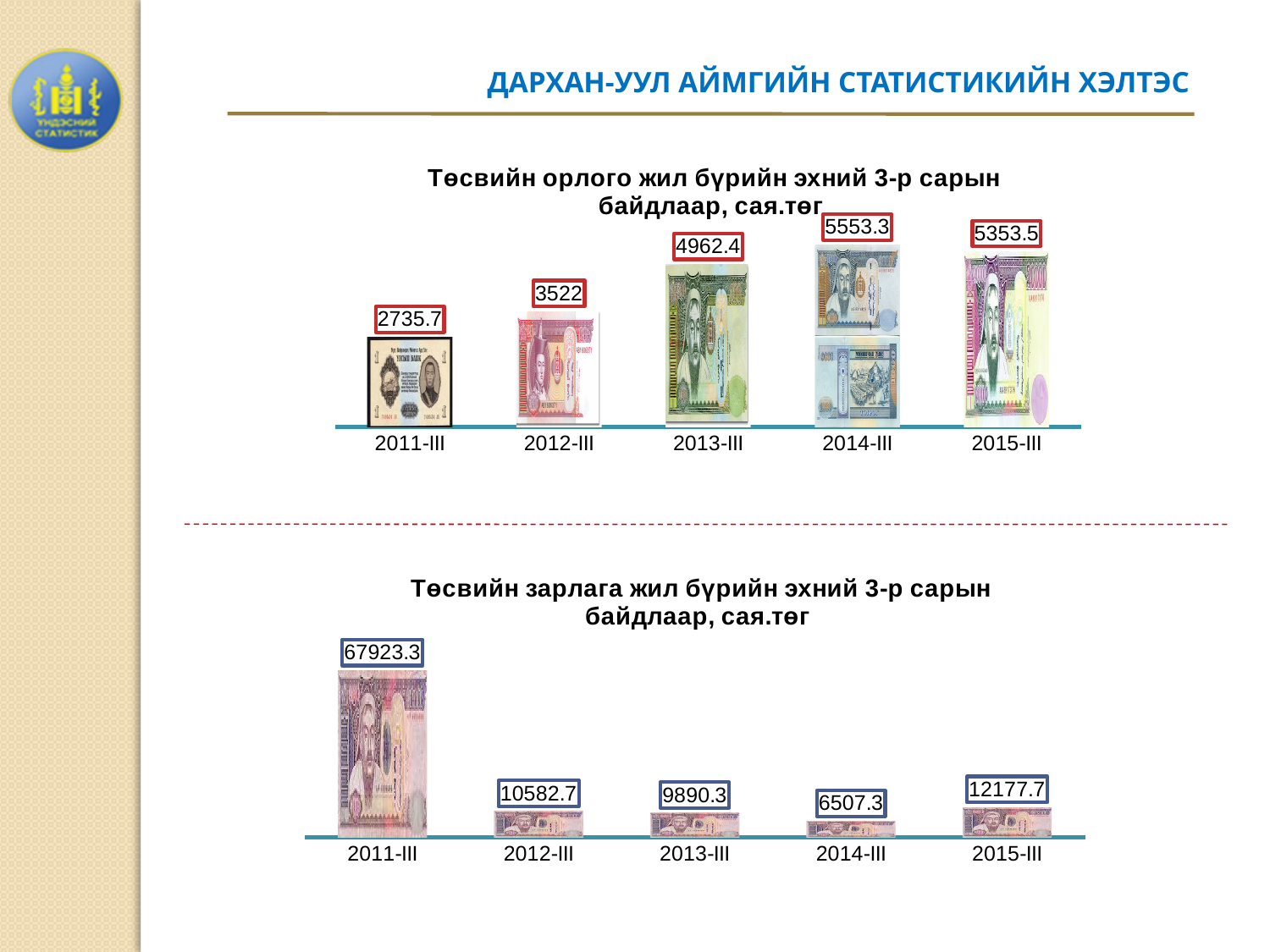
In the bottom chart (Төсвийн зарлага), what is the difference between the values for 2015-III and 2014-III? 5670.4 In the bottom chart (Төсвийн зарлага), what is the value for 2011-III? 67923.3 In the bottom chart (Төсвийн зарлага), which year has the lowest value? 2014-III In the top chart (Төсвийн орлого), what is the value for 2013-III? 4962.4 In the bottom chart (Төсвийн зарлага), which is larger, the value for 2012-III or 2013-III? 2012-III In the bottom chart (Төсвийн зарлага), what is the value for 2015-III? 12177.7 In the top chart (Төсвийн орлого), which year has the lowest value? 2011-III In the top chart (Төсвийн орлого), what is the value for 2011-III? 2735.7 What kind of chart is the bottom chart (Төсвийн зарлага)? Bar chart In the top chart (Төсвийн орлого), which year has the highest value? 2014-III In the top chart (Төсвийн орлого), how many years are shown on the x axis? 5 In the top chart (Төсвийн орлого), what is the difference between the values for 2014-III and 2015-III? 199.8